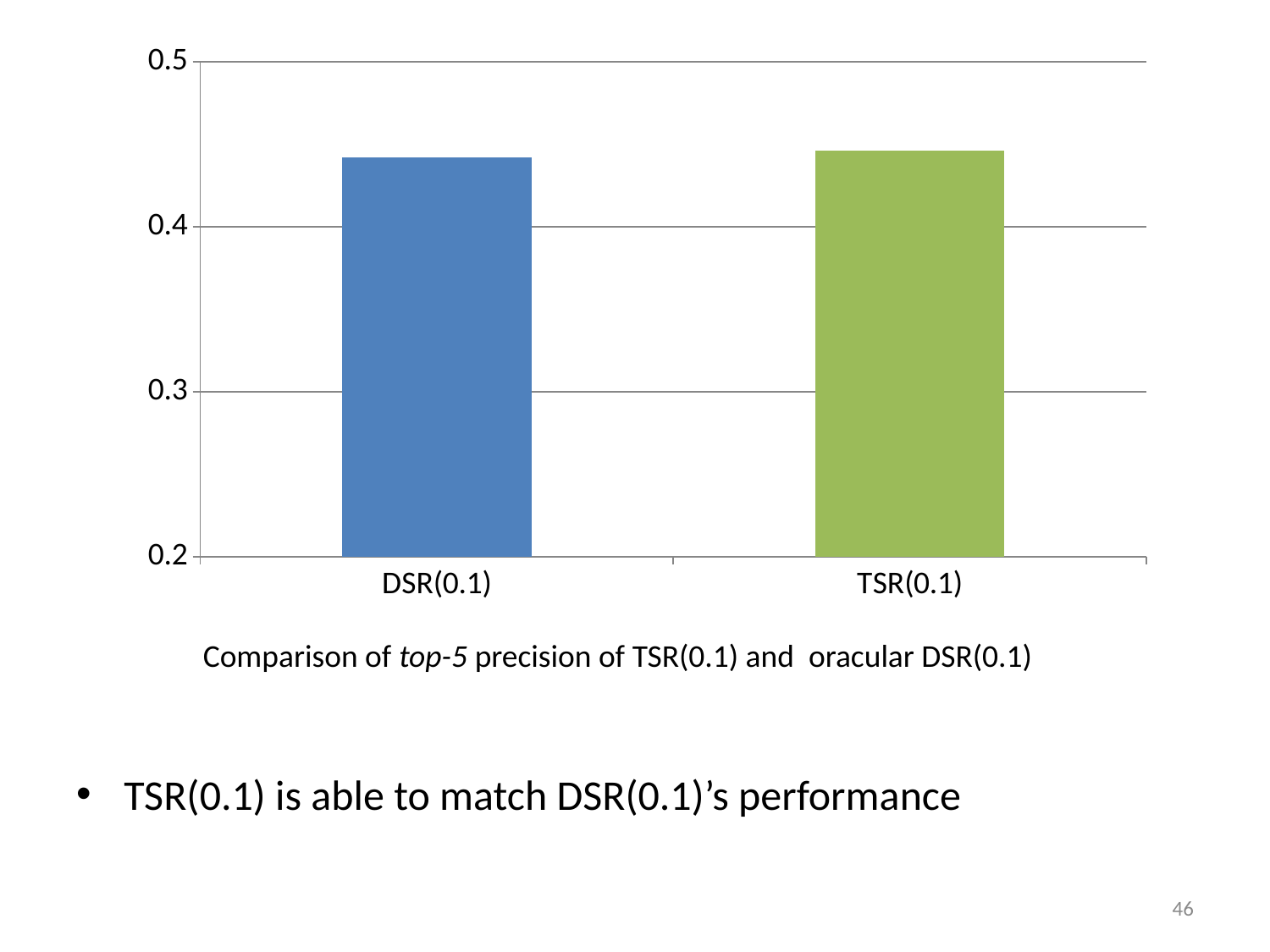
What colour is the bar for TSR(0.1)? green Is the value for TSR(0.1) greater or less than 0.3? greater Is the value for TSR(0.1) greater or less than 0.5? less Is the value for DSR(0.1) greater or less than 0.4? greater What is the lowest value shown on the y axis? 0.2 How many categories are plotted in the chart? 2 What is the highest value shown on the y axis? 0.5 What kind of chart is shown on the slide? bar chart What are the labels of the two categories on the x axis? DSR(0.1) and TSR(0.1)